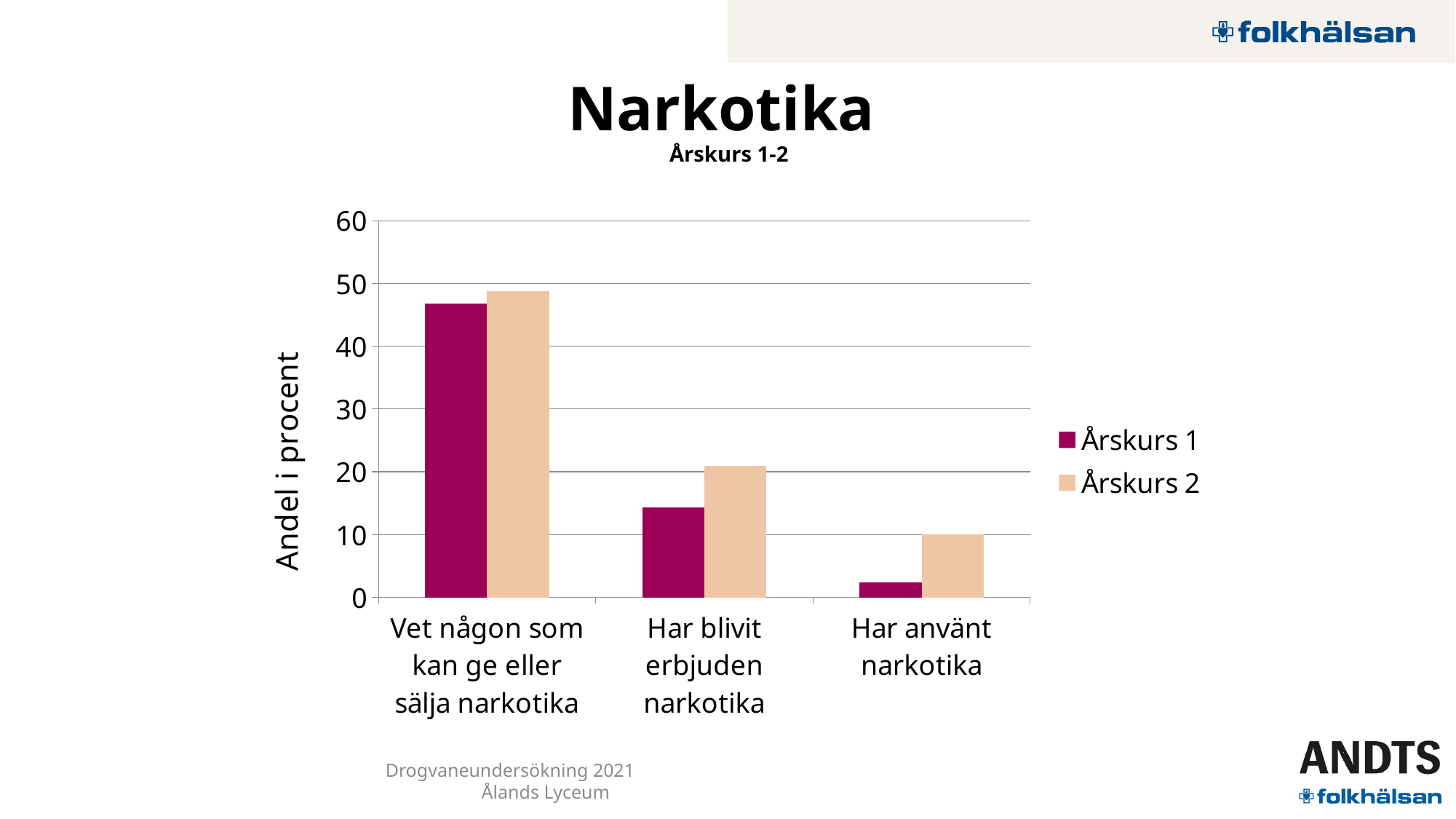
What is the title of the chart? Narkotika Is the value for Årskurs 1 in 'Har använt narkotika' greater or less than 10? less Is the value for Årskurs 2 in 'Har blivit erbjuden narkotika' greater or less than 30? less For 'Har blivit erbjuden narkotika', which series has the larger value, Årskurs 1 or Årskurs 2? Årskurs 2 How many series does the legend list? 2 How many categories are shown on the x axis? 3 Which category has the lowest value for Årskurs 1? Har använt narkotika Which category has the highest value for Årskurs 2? Vet någon som kan ge eller sälja narkotika What is the label of the y axis? Andel i procent What kind of chart is shown on the slide? bar chart Is the value for Årskurs 1 in 'Vet någon som kan ge eller sälja narkotika' greater or less than 40? greater Do the values for Årskurs 1 rise or fall from left to right across the categories? fall